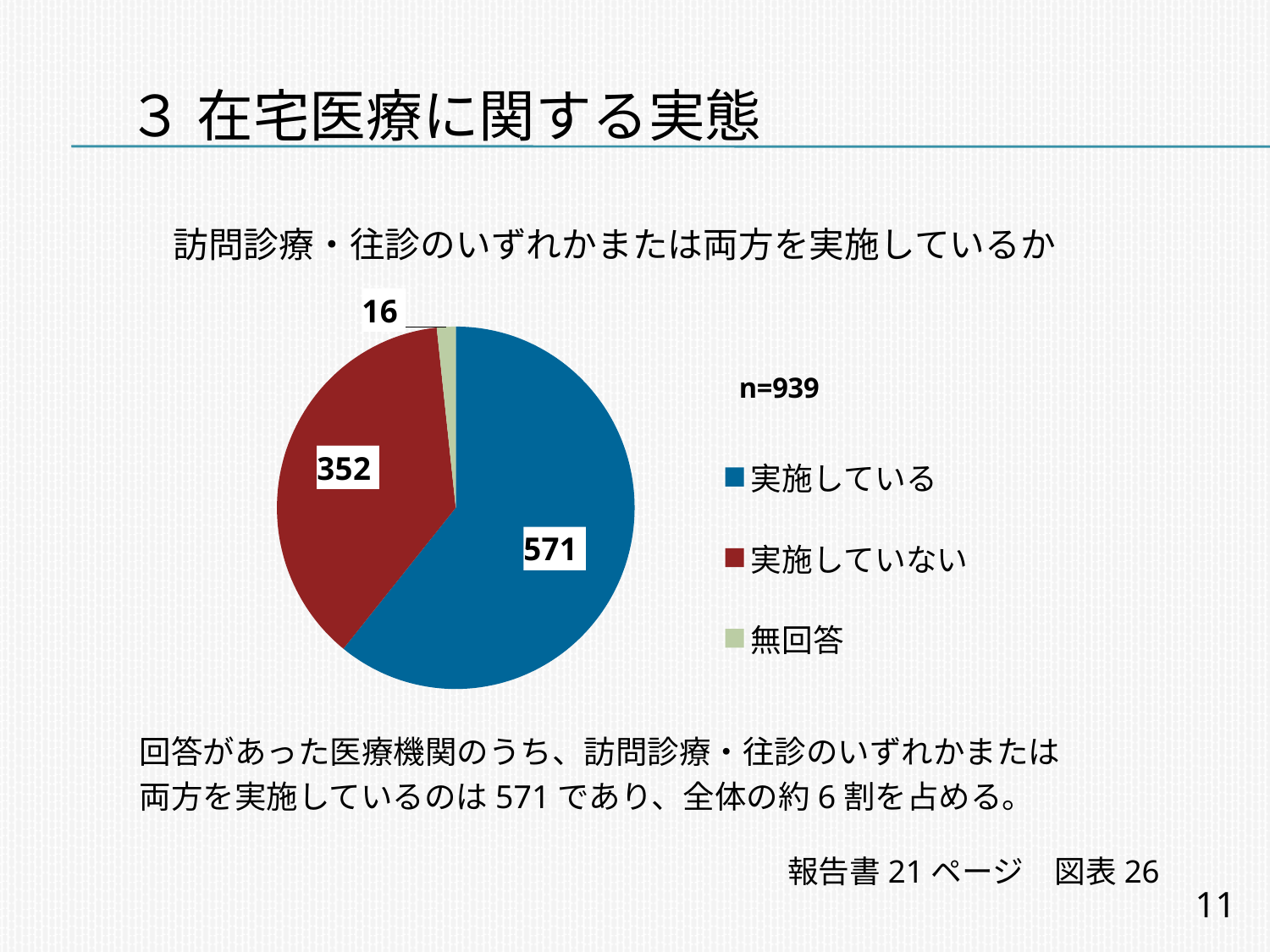
What is the difference between the values for 実施している and 実施していない? 219 What is the value for 実施している? 571 What is the title of the pie chart? 訪問診療・往診のいずれかまたは両方を実施しているか Which is larger, the value for 実施していない or the value for 無回答? 実施していない Which category has the smallest slice of the pie? 無回答 What is the sample size (n) shown next to the chart? n=939 What type of chart is shown on the slide? pie chart How many categories does the pie chart have? 3 What is the value for 無回答? 16 What is the total of all slices in the pie chart? 939 Which category has the largest slice of the pie? 実施している What is the value for 実施していない? 352